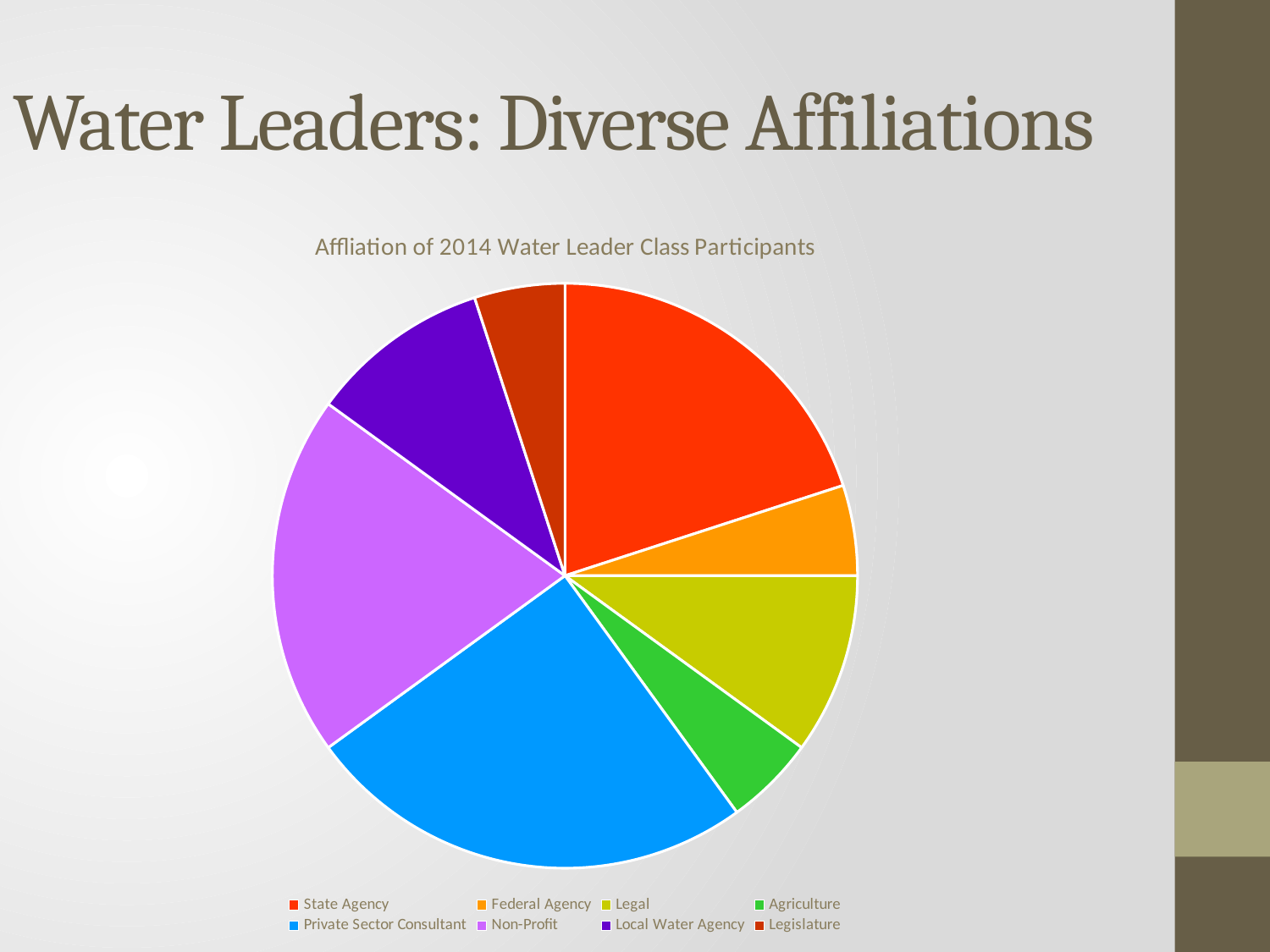
What colour is the Private Sector Consultant slice? blue Which slice is larger, Local Water Agency or Legislature? Local Water Agency What is the title of the chart? Affliation of 2014 Water Leader Class Participants Which slice is larger, Private Sector Consultant or Agriculture? Private Sector Consultant Which slice is larger, Legal or Agriculture? Legal How many entries does the legend list? 8 Which affiliation has the largest slice of the pie? Private Sector Consultant How many categories (slices) does the pie chart have? 8 What kind of chart is shown on the slide? pie chart